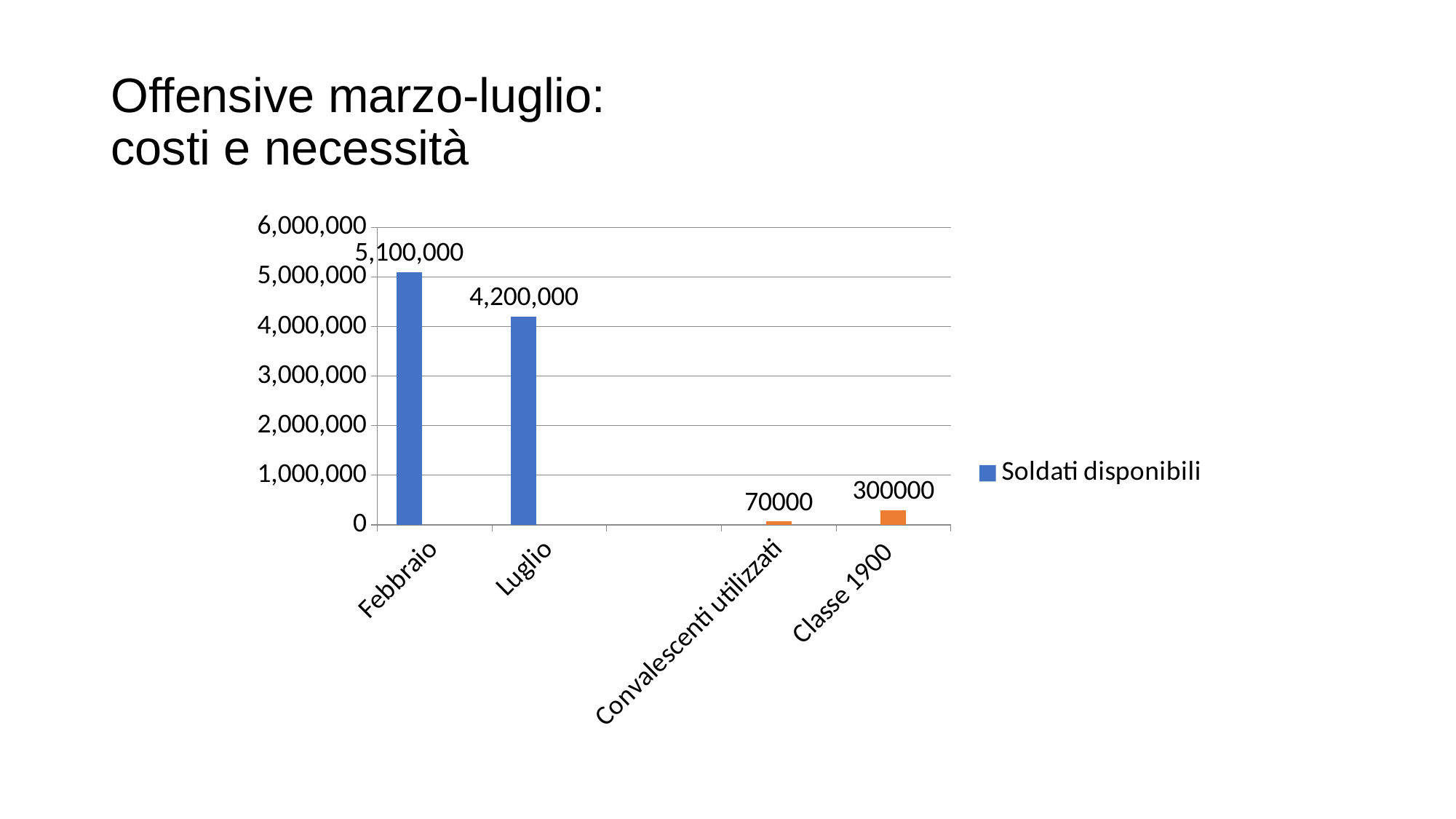
Which category has the highest value? Febbraio What is the value for Convalescenti utilizzati? 70000 Which category has the lowest value? Convalescenti utilizzati How many categories are shown on the x axis? 4 Which is larger, the value for Classe 1900 or the value for Convalescenti utilizzati? Classe 1900 What is the value for Febbraio? 5,100,000 What series name does the legend list? Soldati disponibili Is the value for Luglio greater or less than 4,000,000? greater What is the difference between the values for Febbraio and Luglio? 900,000 What is the value for Classe 1900? 300000 What is the value for Luglio? 4,200,000 What kind of chart is shown on the slide? bar chart